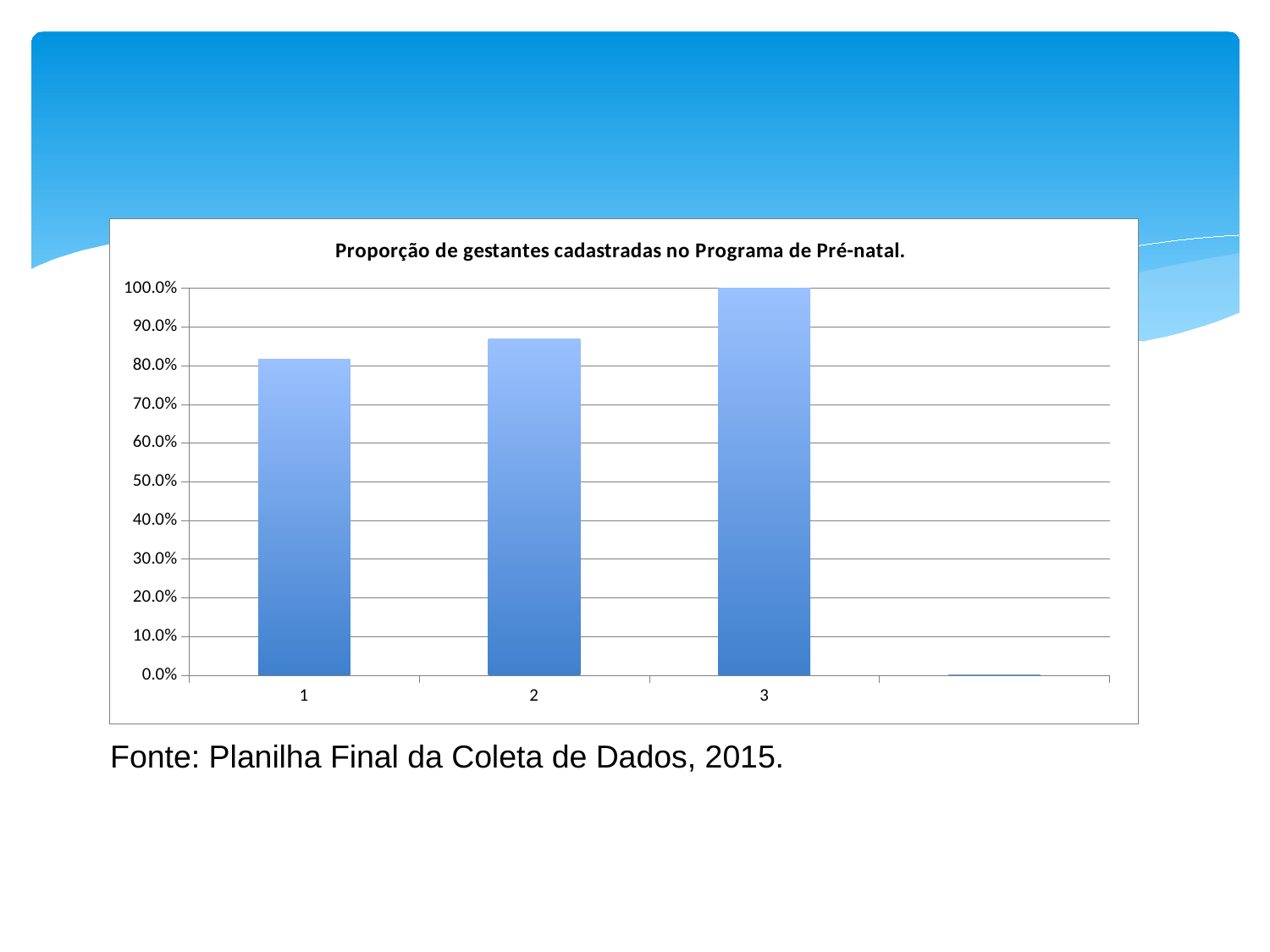
Is the value for category 1 greater or less than 90.0%? less Which of the labeled categories 1, 2 and 3 has the lowest value? 1 Is the value for category 2 greater or less than 80.0%? greater Is the value for category 2 greater or less than 90.0%? less What is the highest tick shown on the vertical axis? 100.0% What kind of chart is shown on the slide? bar chart Which labeled category has the highest value? 3 Which is larger, the value for category 1 or the value for category 2? 2 What is the value for category 3? 100.0% What is the title of the chart? Proporção de gestantes cadastradas no Programa de Pré-natal. Do the values rise or fall from category 1 to category 3? rise